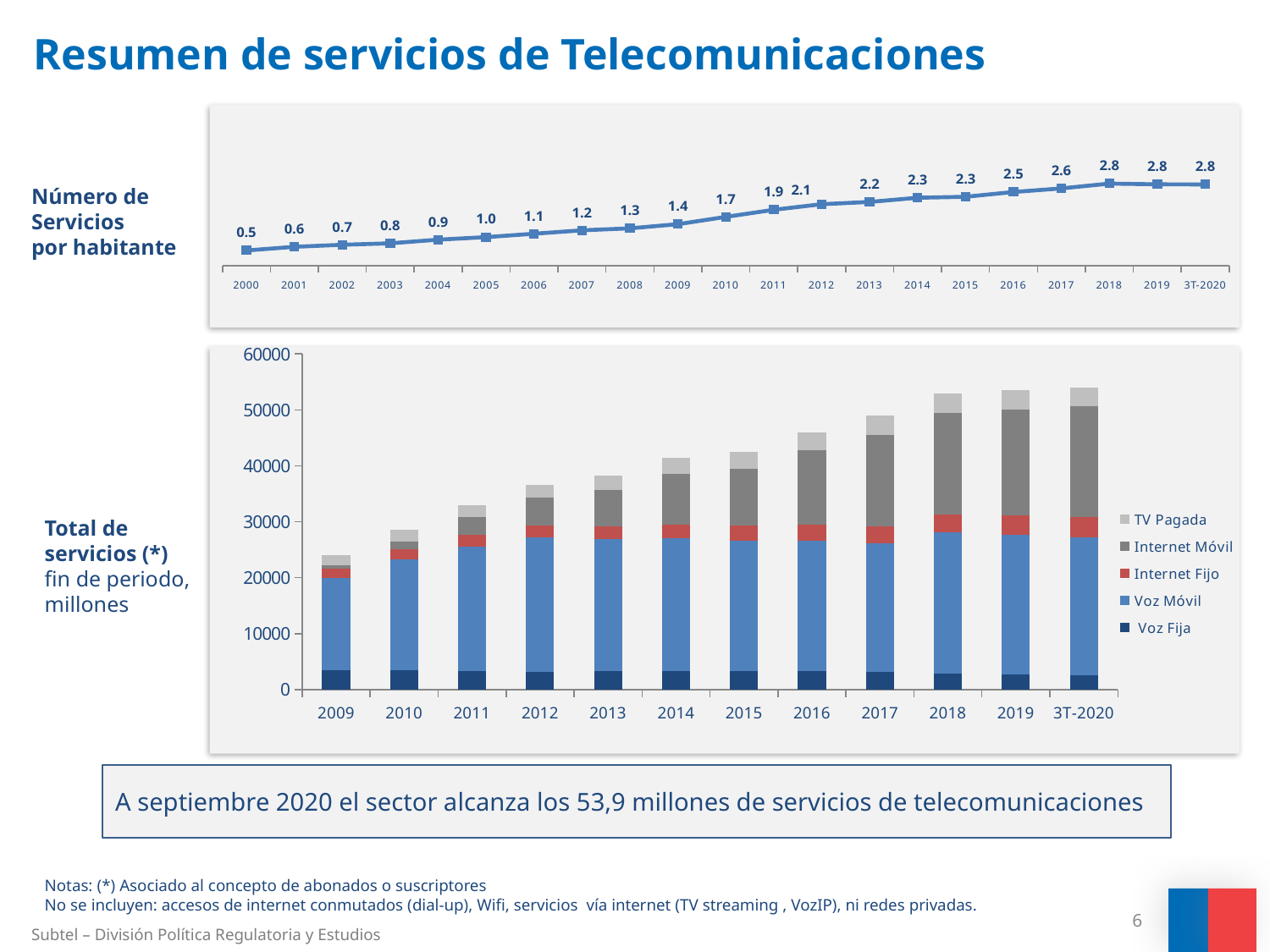
In the top chart 'Número de Servicios por habitante', how many data points are plotted? 21 In the top chart 'Número de Servicios por habitante', what is the value for 2010? 1.7 In the bottom chart 'Total de servicios', how many series does the legend list? 5 In the bottom chart 'Total de servicios', is the total stacked value for 3T-2020 greater or less than 50000? greater In the top chart 'Número de Servicios por habitante', what is the difference between the values for 2018 and 2000? 2.3 In the bottom chart 'Total de servicios', is the total stacked value for 2009 greater or less than 30000? less In the top chart 'Número de Servicios por habitante', which year has the lowest value? 2000 In the top chart 'Número de Servicios por habitante', what is the value for 3T-2020? 2.8 What kind of chart is the top chart, 'Número de Servicios por habitante'? line chart In the bottom chart 'Total de servicios', how many periods are shown on the x axis? 12 In the top chart 'Número de Servicios por habitante', do the values generally rise or fall from 2000 to 3T-2020? rise What kind of chart is the bottom chart, 'Total de servicios (*) fin de periodo, millones'? bar chart